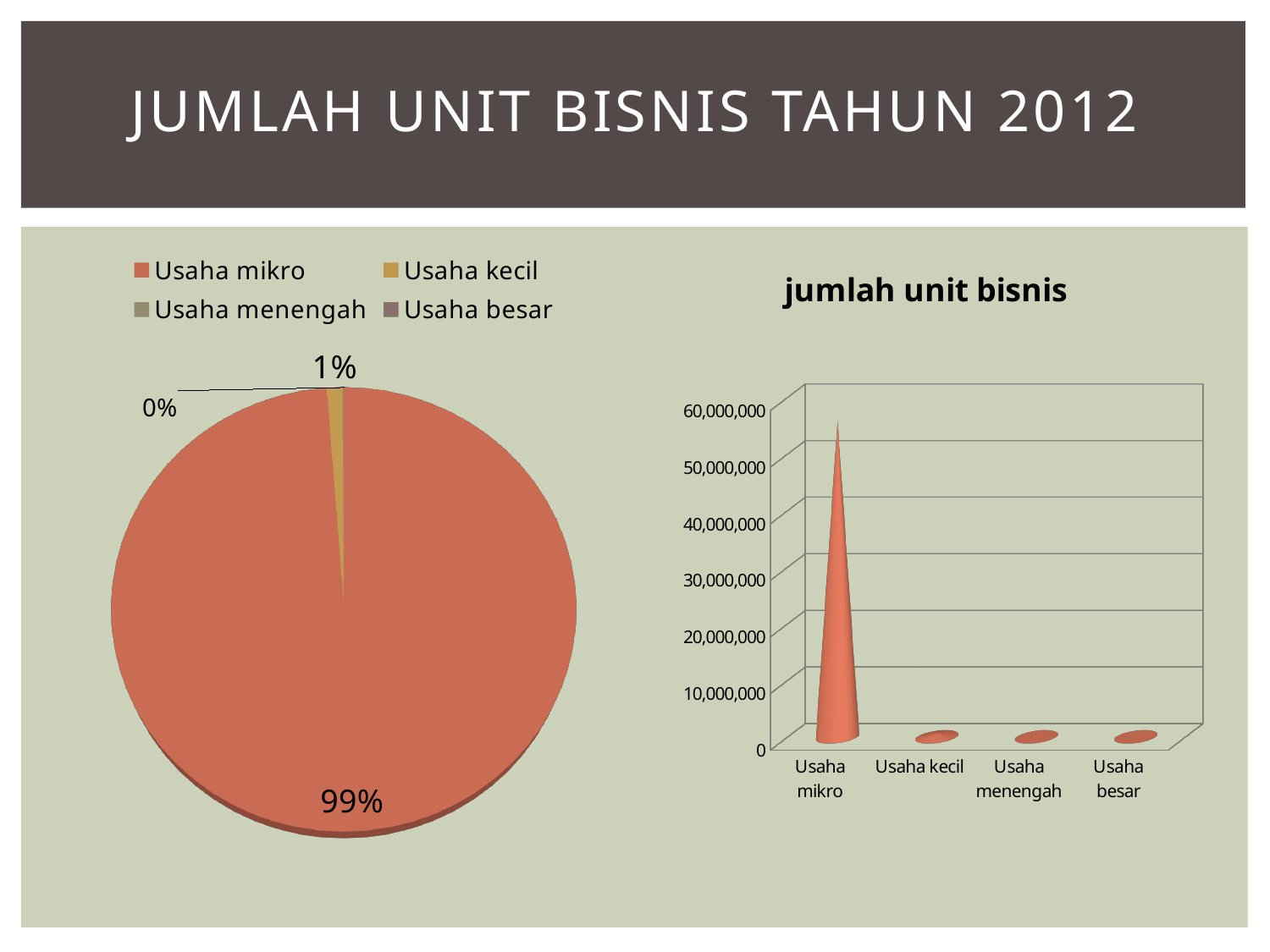
What kind of chart is the chart titled "jumlah unit bisnis"? Bar chart In the chart titled "jumlah unit bisnis", which category has the highest value? Usaha mikro What is the title of the chart on the right of the slide? jumlah unit bisnis In the chart titled "jumlah unit bisnis", how many categories are shown on the x axis? 4 In the chart titled "jumlah unit bisnis", is the value for Usaha mikro greater or less than 50,000,000? greater On the pie chart on the left, what share does Usaha mikro have? 99% In the chart titled "jumlah unit bisnis", is the value for Usaha kecil greater or less than 10,000,000? less On the pie chart on the left, which category has the largest slice? Usaha mikro On the pie chart on the left, what share does Usaha kecil have? 1% In the chart titled "jumlah unit bisnis", which is larger, the value for Usaha mikro or the value for Usaha besar? Usaha mikro What kind of chart is the chart on the left of the slide? Pie chart How many entries does the legend of the pie chart on the left list? 4